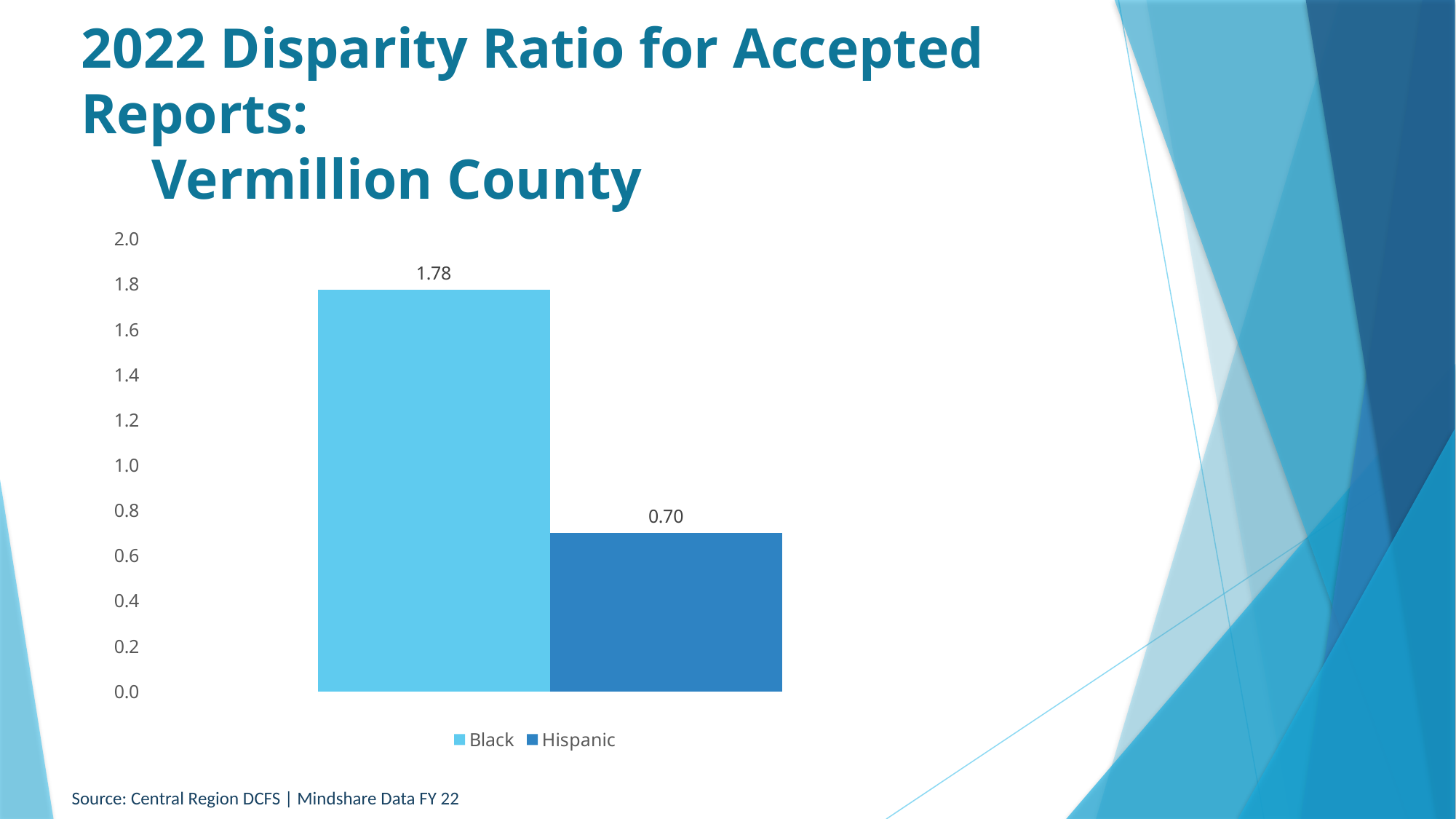
What is the disparity ratio for Hispanic? 0.70 What is the disparity ratio for Black? 1.78 What is the difference between the Black and Hispanic disparity ratios? 1.08 Which county does the chart title refer to? Vermillion County Which group has the higher disparity ratio? Black What kind of chart is shown on the slide? Bar chart Is the disparity ratio for Hispanic greater or less than 1.0? less Which group has the lower disparity ratio? Hispanic How many series does the legend list? 2 What is the maximum value shown on the vertical axis? 2.0 Is the disparity ratio for Black greater or less than 1.0? greater